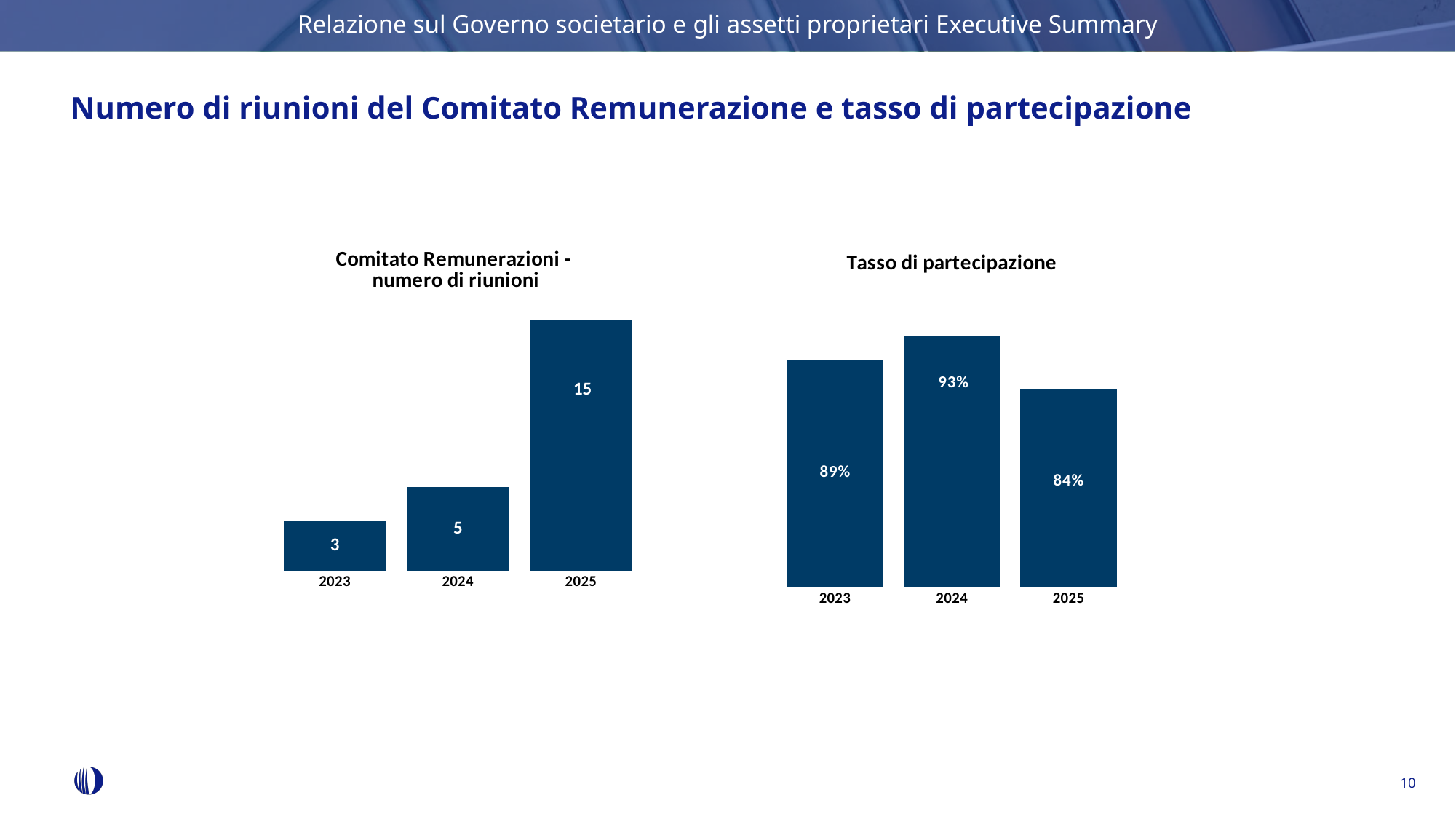
In the 'Comitato Remunerazioni - numero di riunioni' chart, do the values rise or fall from 2023 to 2025? Rise What kind of chart is the 'Tasso di partecipazione' chart? Bar chart In the 'Comitato Remunerazioni - numero di riunioni' chart, what is the value for 2025? 15 In the 'Tasso di partecipazione' chart, what is the value for 2025? 84% In the 'Comitato Remunerazioni - numero di riunioni' chart, which year has the highest value? 2025 In the 'Tasso di partecipazione' chart, what is the difference between the values for 2024 and 2023? 4% In the 'Comitato Remunerazioni - numero di riunioni' chart, what is the value for 2023? 3 In the 'Tasso di partecipazione' chart, which is larger, the value for 2023 or the value for 2025? 2023 In the 'Comitato Remunerazioni - numero di riunioni' chart, what is the difference between the values for 2025 and 2024? 10 In the 'Tasso di partecipazione' chart, which year has the lowest value? 2025 How many years are shown in the 'Comitato Remunerazioni - numero di riunioni' chart? 3 In the 'Tasso di partecipazione' chart, what is the value for 2024? 93%